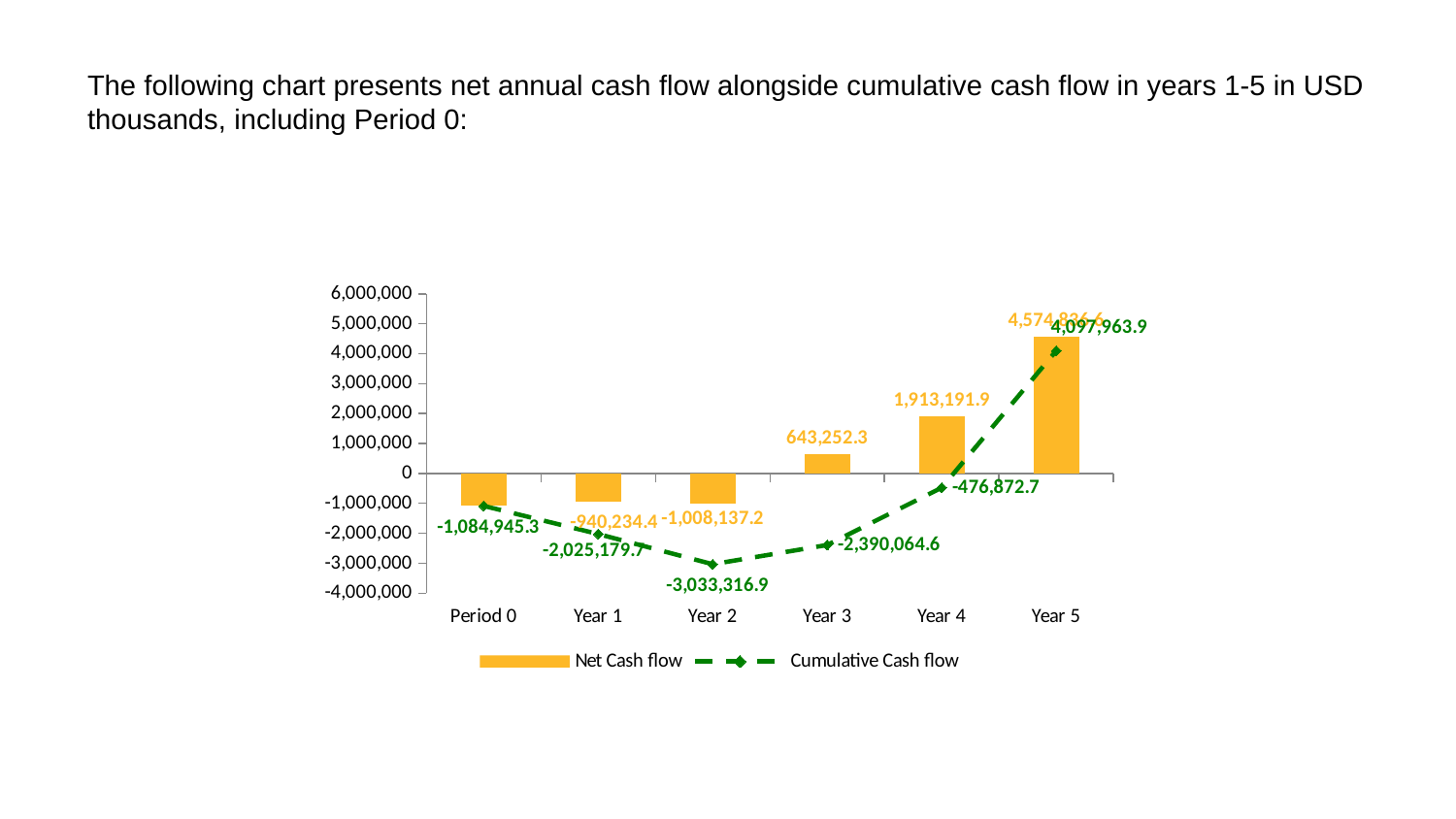
In which period is the Cumulative Cash flow lowest? Year 2 How many series does the legend list? 2 Which has the lower Net Cash flow, Year 1 or Year 2? Year 2 In which period is the Net Cash flow highest? Year 5 What is the Net Cash flow value for Year 3? 643,252.3 Is the Net Cash flow for Year 5 greater or less than 4,000,000? greater What is the Cumulative Cash flow value for Year 4? -476,872.7 What is the Cumulative Cash flow value for Year 5? 4,097,963.9 What is the Net Cash flow value for Year 4? 1,913,191.9 What is the difference between the Net Cash flow in Year 4 and in Year 3? 1,269,939.6 What is the Cumulative Cash flow value for Year 2? -3,033,316.9 How many periods are shown on the x axis? 6